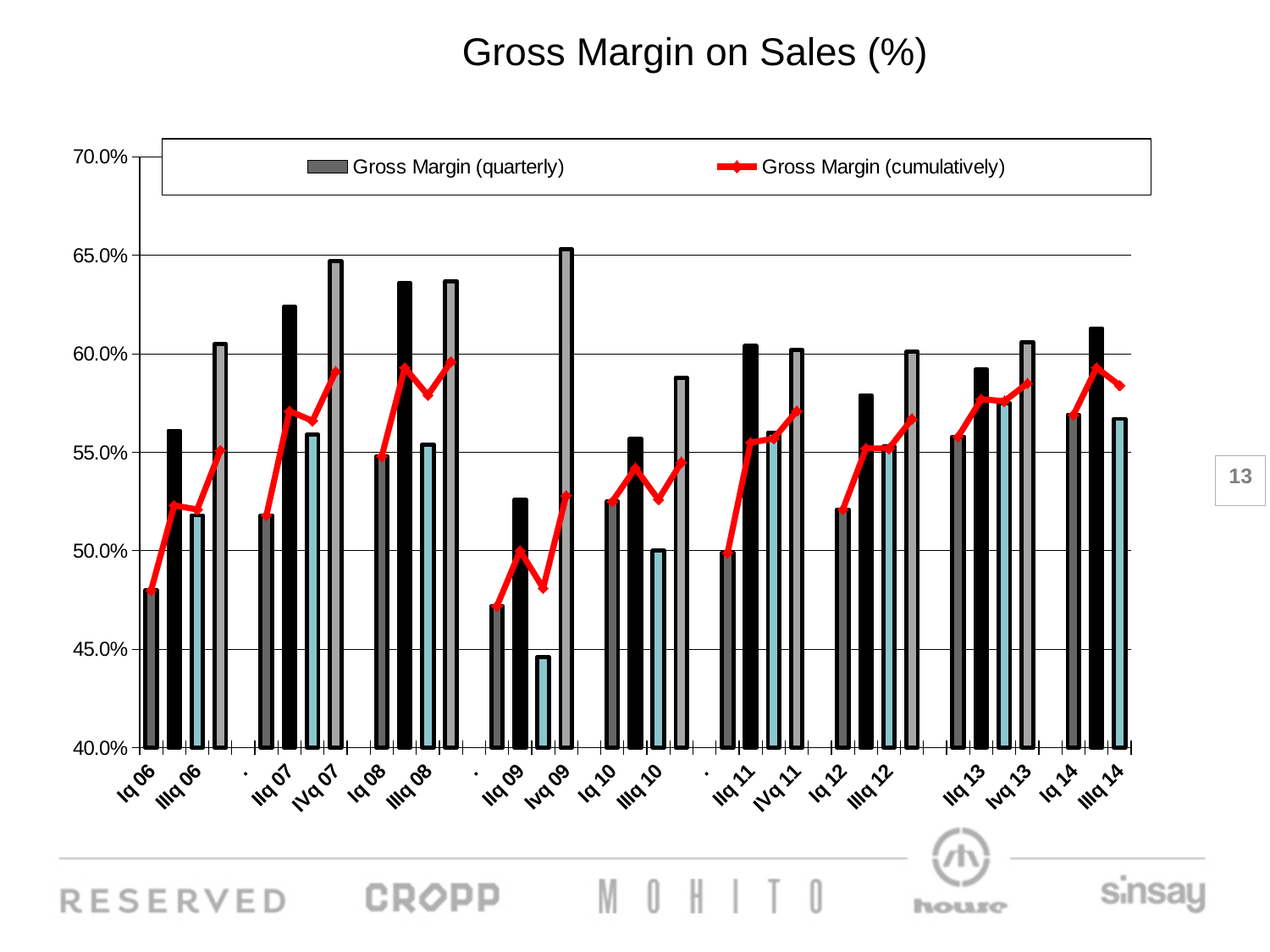
Which has the larger quarterly gross margin bar, Iq 10 or IIIq 10? Iq 10 Which has the larger quarterly gross margin bar, IIq 09 or IVq 09? IVq 09 What kind of chart is shown on the slide? Bar chart with a line overlay How many series does the legend list? 2 Which series is drawn as a red line with markers? Gross Margin (cumulatively) Is the quarterly gross margin bar for Iq 06 greater or less than 50.0%? less Is the quarterly gross margin bar for IVq 07 greater or less than 60.0%? greater What is the title of the chart? Gross Margin on Sales (%) Is the quarterly gross margin bar for IIIq 14 greater or less than 55.0%? greater Does the cumulative gross margin line rise or fall from IIq 09 to IVq 09? rise Which has the larger quarterly gross margin bar, Iq 06 or IIIq 06? IIIq 06